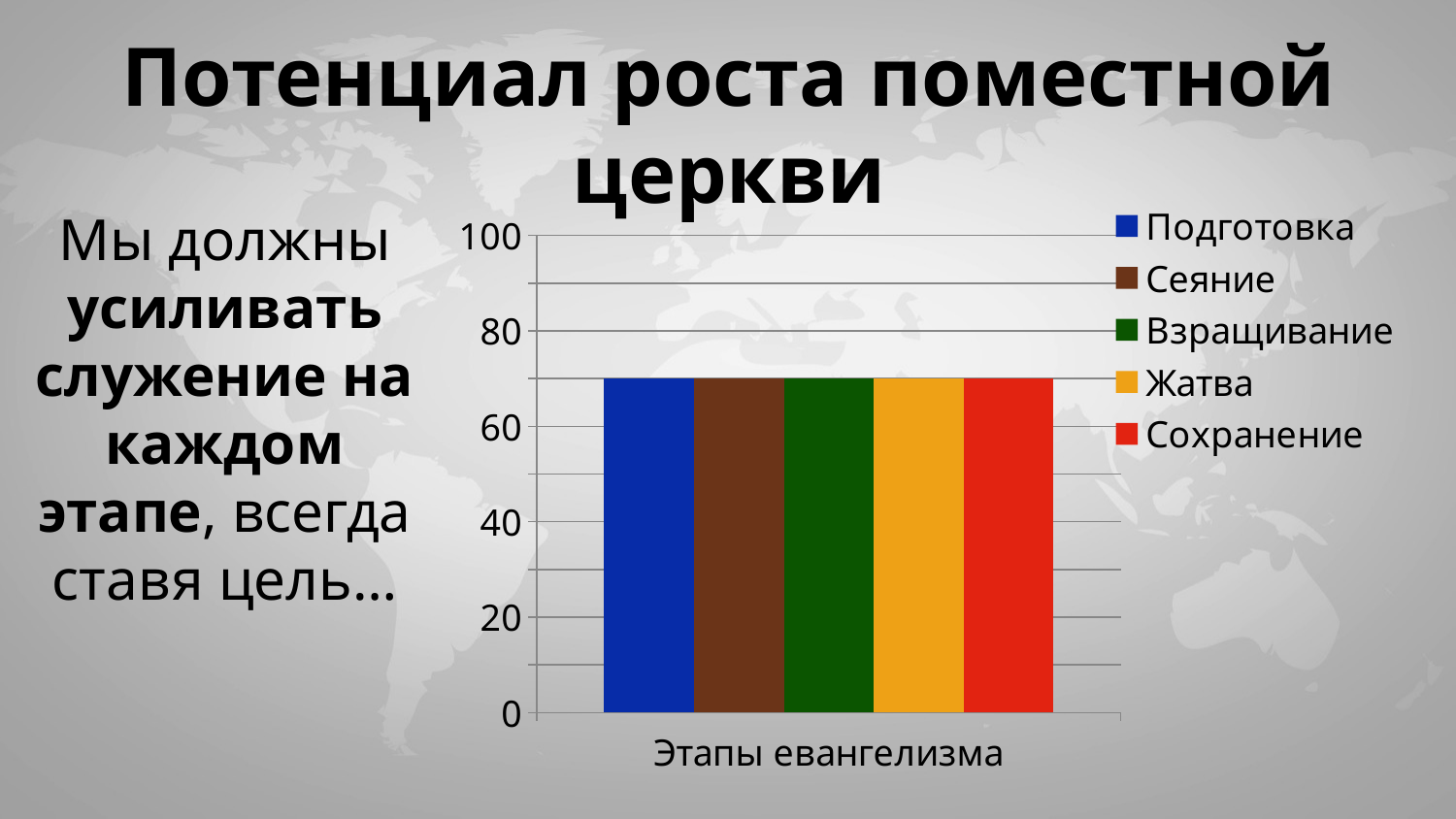
Is the value for Сохранение greater or less than 60? greater Is the value for Жатва greater or less than 100? less Is the value for Сеяние greater or less than 80? less What kind of chart is shown on the slide? bar chart What is the label of the category on the x axis? Этапы евангелизма What is the highest value shown on the vertical axis of the chart? 100 Which series is shown in red in the chart legend? Сохранение How many series does the chart legend list? 5 How many categories are shown on the x axis of the chart? 1